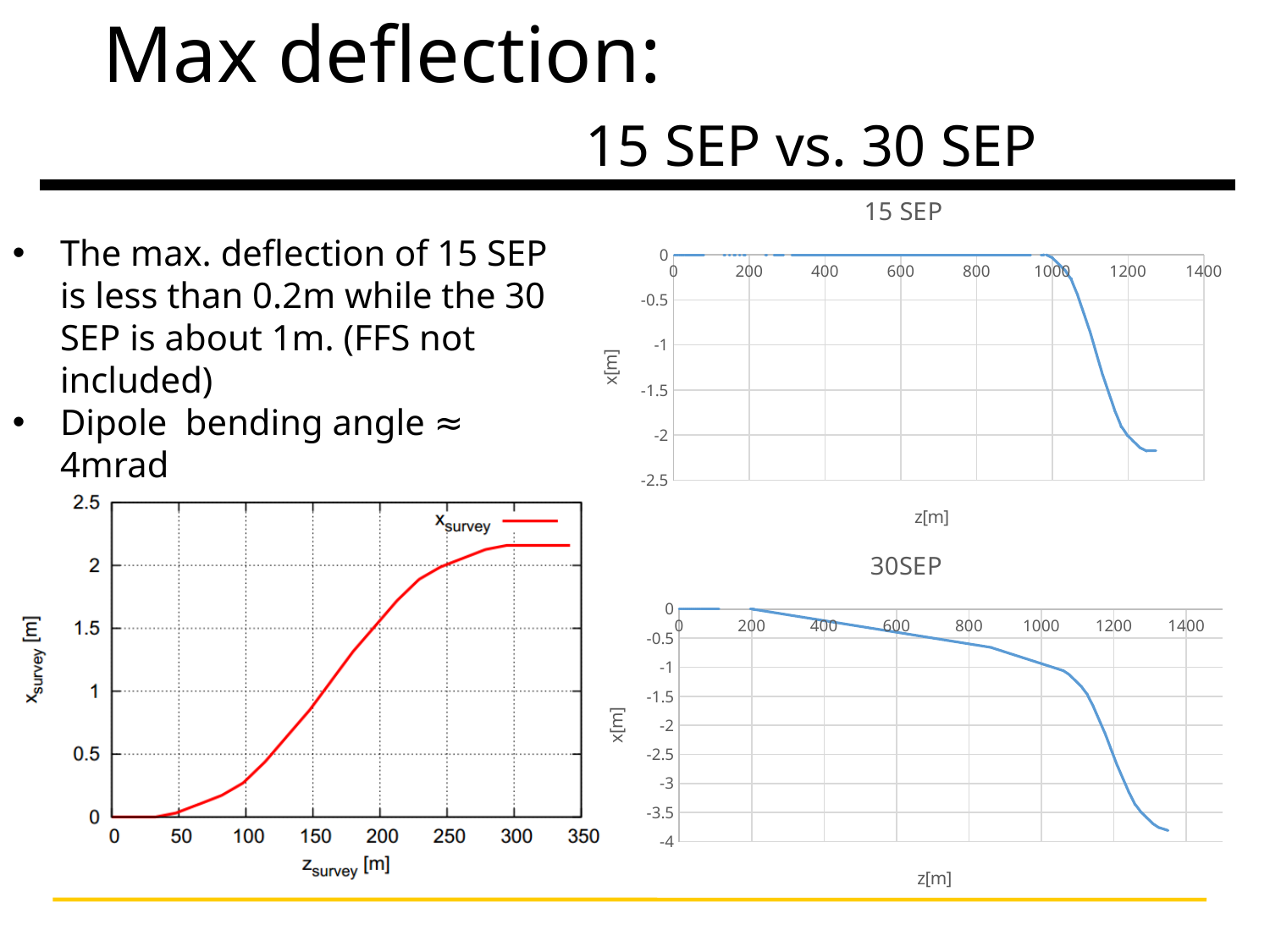
Which chart's curve reaches a lower minimum value, '15 SEP' or '30SEP'? 30SEP In the '30SEP' chart, is the value at z = 400 greater or less than -0.5? greater In the '15 SEP' chart, is the final value of the curve at the right end greater or less than -2? less In the '30SEP' chart, do the values rise or fall as z[m] increases? fall In the bottom-left chart, is the value of x_survey at z_survey = 300 greater or less than 2? greater How many series does the legend of the bottom-left chart list? 1 In the '15 SEP' chart, do the values rise or fall as z[m] increases? fall What kind of chart is the '15 SEP' chart on the right of the slide? line chart What is the y-axis label of the '30SEP' chart? x[m] In the bottom-left chart, does x_survey rise or fall as z_survey increases? rise